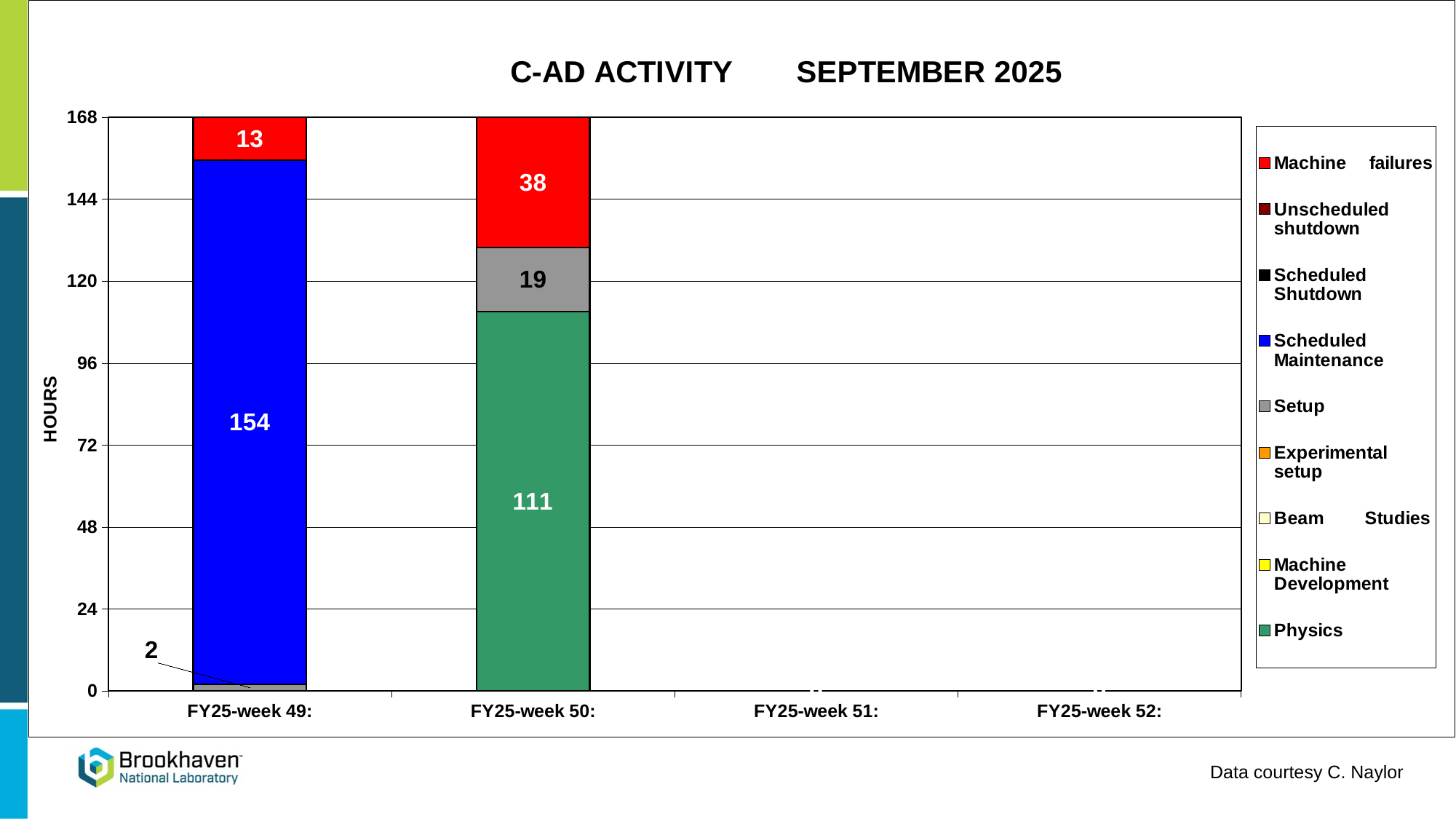
What is the label on the y axis? HOURS How many categories are shown on the x axis? 4 How many hours of Physics are shown for FY25-week 50? 111 What is the title of the chart? C-AD ACTIVITY SEPTEMBER 2025 What is the total of the stacked bar for FY25-week 50? 168 What is the difference in Machine failures hours between FY25-week 50 and FY25-week 49? 25 Which week has more Setup hours, FY25-week 49 or FY25-week 50? FY25-week 50 How many hours of Machine failures are shown for FY25-week 50? 38 What kind of chart is shown on the slide? stacked bar chart How many series does the legend list? 9 How many hours of Scheduled Maintenance are shown for FY25-week 49? 154 How many hours of Setup are shown for FY25-week 49? 2